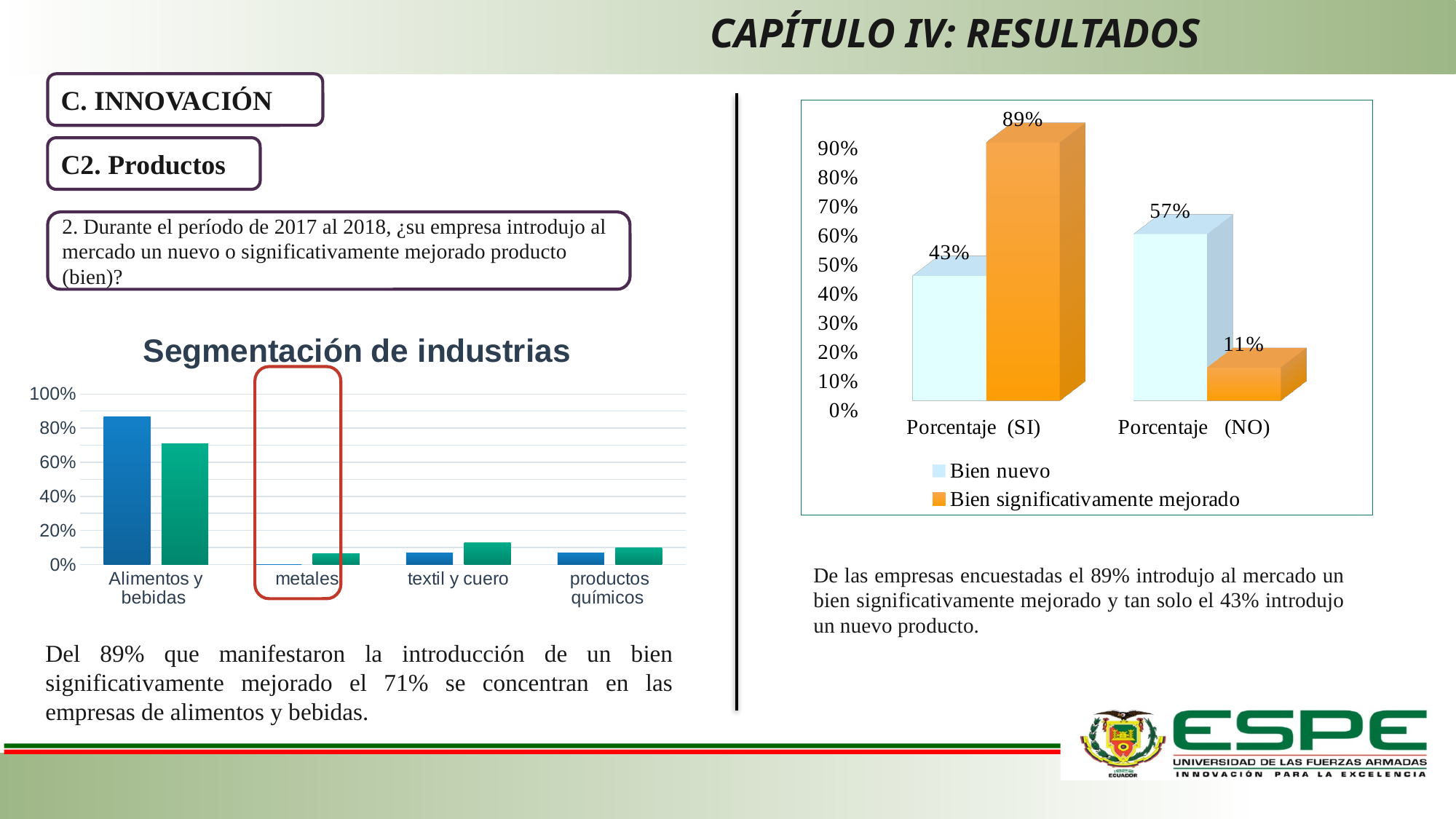
In the right-hand chart, which is larger for 'Porcentaje (NO)': 'Bien nuevo' or 'Bien significativamente mejorado'? Bien nuevo In the right-hand chart, what is the value of 'Bien nuevo' for 'Porcentaje (NO)'? 57% In the right-hand chart, what is the value of 'Bien significativamente mejorado' for 'Porcentaje (SI)'? 89% In the right-hand chart, which bar has the lowest value? Bien significativamente mejorado, Porcentaje (NO) What kind of chart is 'Segmentación de industrias'? Bar chart In the right-hand chart, what is the value of 'Bien significativamente mejorado' for 'Porcentaje (NO)'? 11% In the 'Segmentación de industrias' chart, is the value of the green bar for 'textil y cuero' greater or less than 20%? less In the right-hand chart, what is the difference between the two bars for 'Porcentaje (SI)'? 46 percentage points In the 'Segmentación de industrias' chart, is the value of the blue bar for 'Alimentos y bebidas' greater or less than 80%? greater In the 'Segmentación de industrias' chart, how many industry categories are shown on the x axis? 4 In the right-hand chart, what is the value of 'Bien nuevo' for 'Porcentaje (SI)'? 43% In the right-hand chart, how many series does the legend list? 2